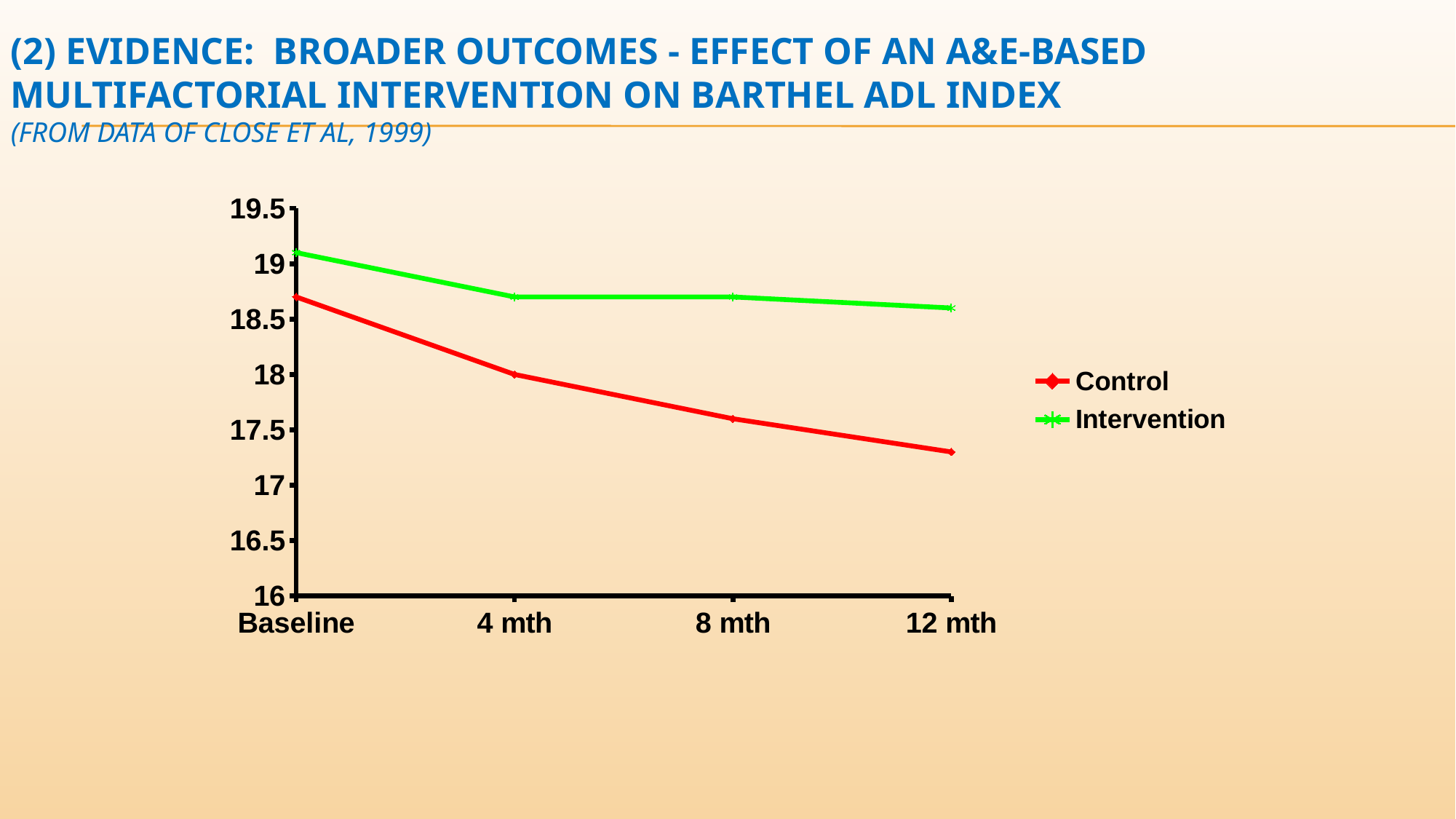
What kind of chart is shown on the slide? line chart Is the value for Intervention at 12 mth greater or less than 18? greater At 12 mth, which series has the higher value, Control or Intervention? Intervention How many series does the legend list? 2 Is the value for Intervention at Baseline greater or less than 18.5? greater Which series is drawn in green? Intervention Is the value for Control at 8 mth greater or less than 18? less How many time points are shown on the x axis? 4 What is the value for Control at 4 mth? 18 Does the Control series rise or fall from Baseline to 12 mth? fall